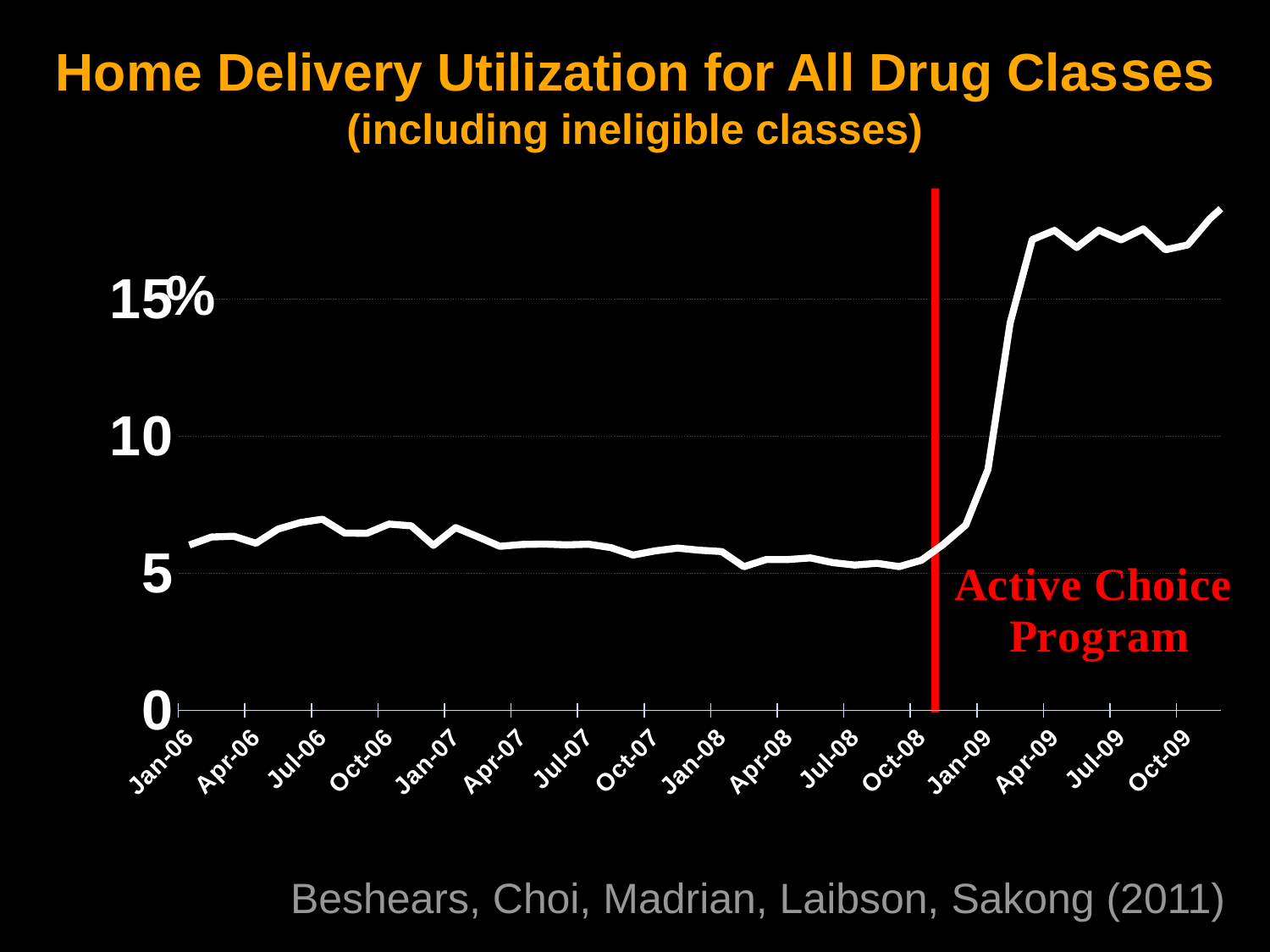
How many date labels are shown on the x axis? 16 What is the highest value labeled on the y axis? 15% Is the value for Jul-08 greater or less than 5? greater Does the line rise or fall immediately after the Active Choice Program line? rise What is the title of the chart? Home Delivery Utilization for All Drug Classes (including ineligible classes) Which is larger, the value for Apr-09 or the value for Jan-06? Apr-09 What kind of chart is shown on the slide? line chart Is the value for Apr-09 greater or less than 15%? greater Is the value for Jul-06 greater or less than 10? less What label is written next to the red vertical line on the chart? Active Choice Program